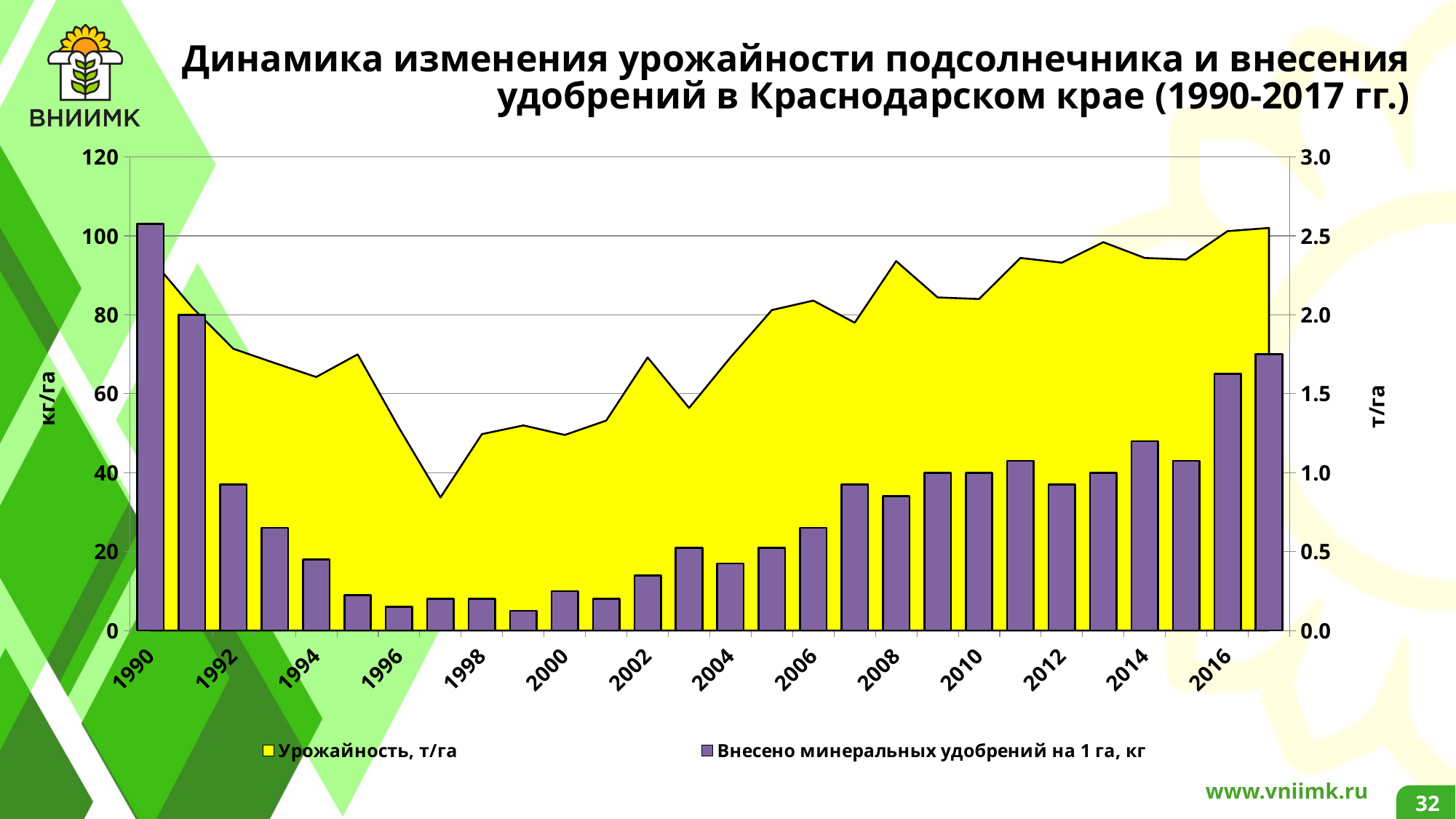
What kind of chart is shown on the slide? A combination of a bar chart and an area chart Is the fertilizer value for 2017 greater or less than 60? greater Is the fertilizer value for 1990 greater or less than 80? greater Does the fertilizer application rise or fall from 1990 to 1999? fall Is the yield value for 1997 greater or less than 1.0? less How many years (bars) are plotted on the chart? 28 How many series does the legend list? 2 In which year was the amount of mineral fertilizer applied per hectare (Внесено минеральных удобрений) the highest? 1990 In which year was sunflower yield (Урожайность) the lowest? 1997 Which year had a higher fertilizer application: 1990 or 2017? 1990